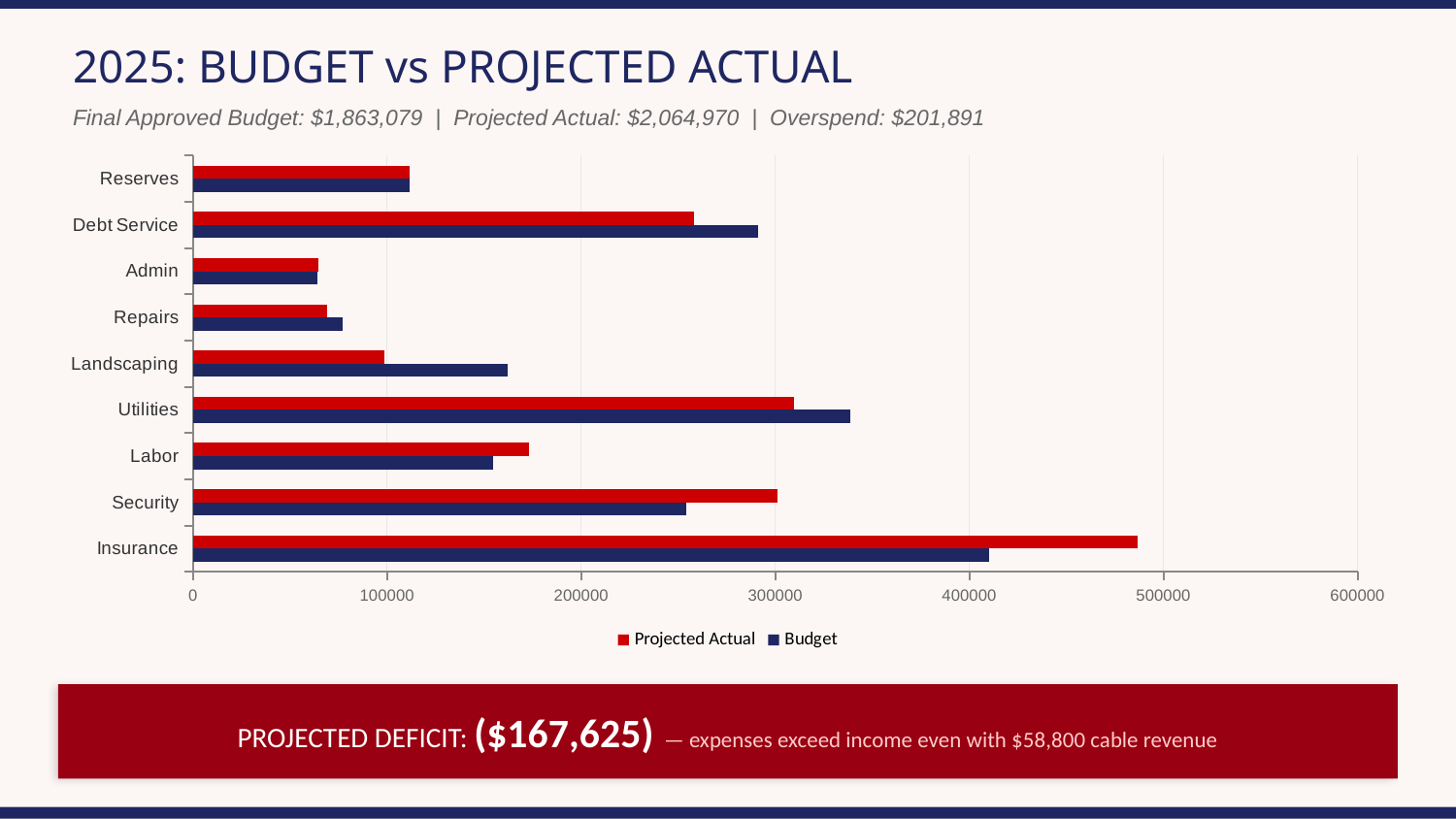
How many expense categories are plotted on the chart? 9 Is the Budget value for Security greater or less than 300000? less How many series does the chart legend list? 2 What kind of chart is shown on the slide? Bar chart Is the Budget value for Utilities greater or less than 300000? greater Which category has the lowest Budget value? Admin For Landscaping, which is larger: Projected Actual or Budget? Budget Which colour represents the Budget series in the chart? Navy blue For Security, which is larger: Projected Actual or Budget? Projected Actual Which category has the highest Projected Actual value? Insurance Is the Projected Actual value for Insurance greater or less than 400000? greater